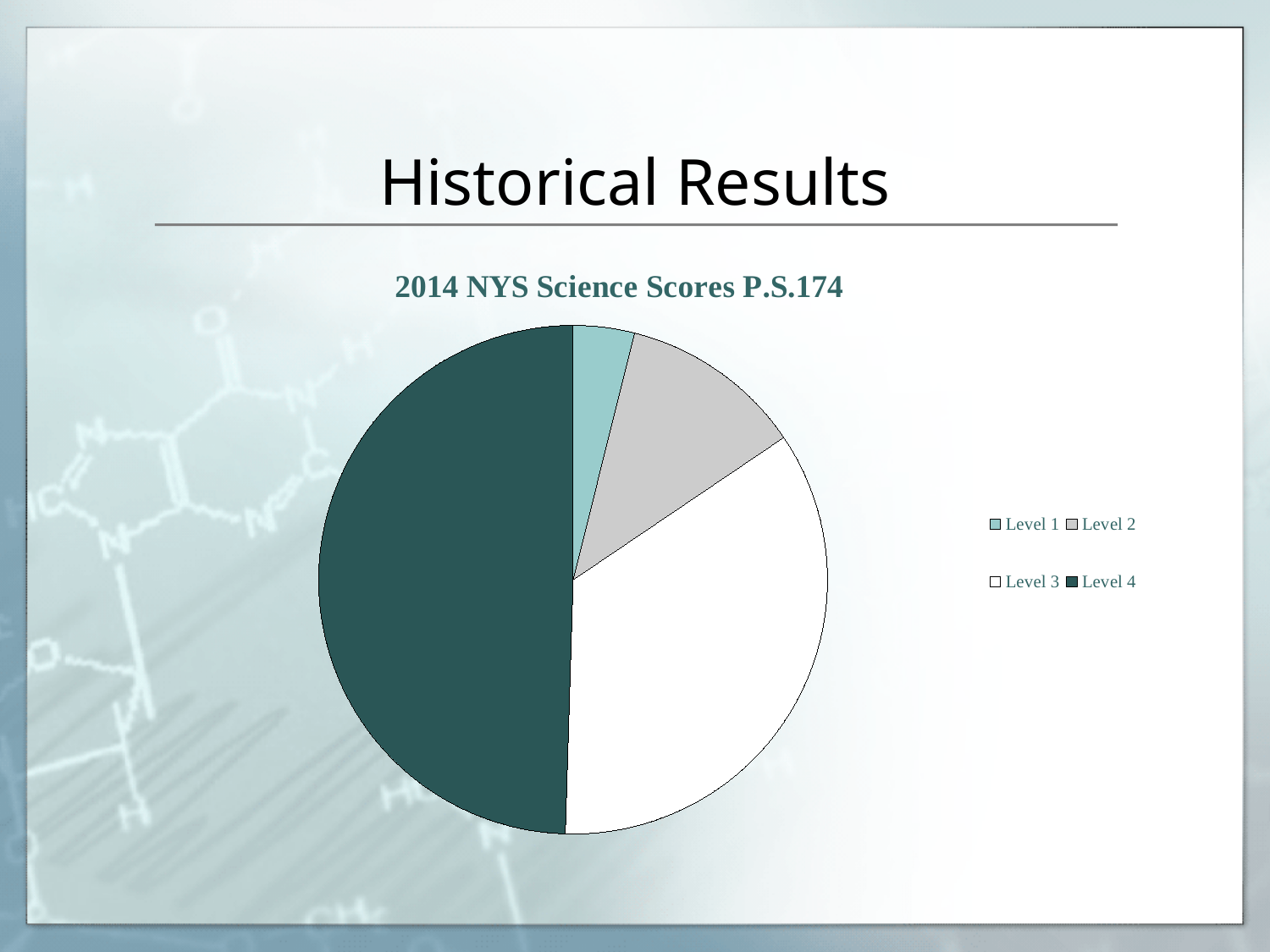
Which slice is larger, Level 2 or Level 1? Level 2 What is the title of the chart? 2014 NYS Science Scores P.S.174 How many entries does the legend list? 4 Which slice is larger, Level 3 or Level 2? Level 3 Which slice is larger, Level 4 or Level 3? Level 4 How many slices does the pie chart have? 4 Which level is shown as the white slice? Level 3 What kind of chart is shown on the slide? pie chart Which level has the largest slice of the pie? Level 4 Which level has the smallest slice of the pie? Level 1